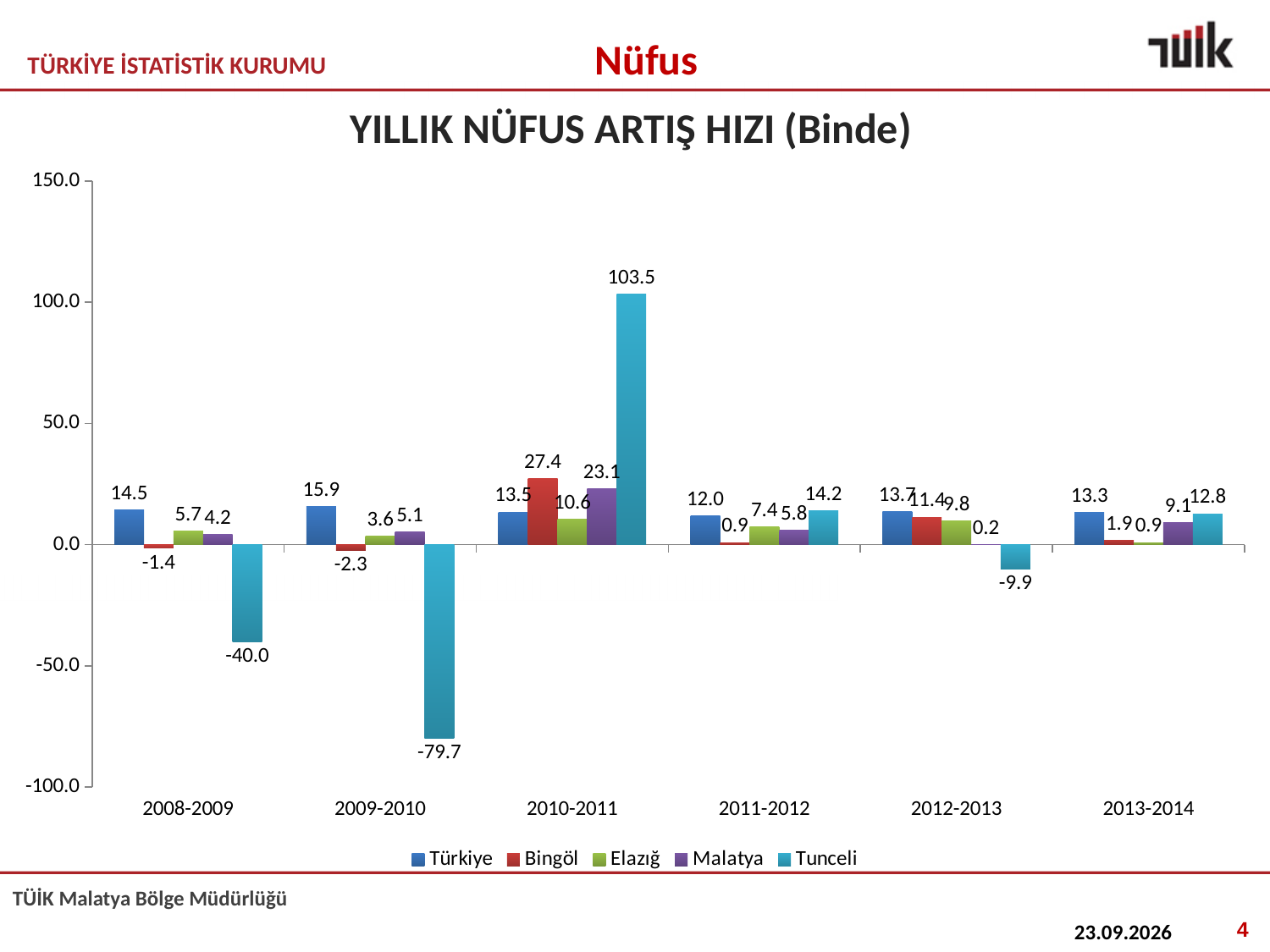
What is the value for Bingöl in 2009-2010? -2.3 What is the value for Malatya in 2012-2013? 0.2 What kind of chart is shown on the slide? Bar chart In which period does Tunceli have its lowest value? 2009-2010 What is the value for Tunceli in 2010-2011? 103.5 How many series does the legend list? 5 Which series has the highest value in 2010-2011? Tunceli What is the title of the chart? YILLIK NÜFUS ARTIŞ HIZI (Binde) Which is larger in 2012-2013, the value for Bingöl or the value for Elazığ? Bingöl How many periods are shown on the x axis? 6 What is the value for Türkiye in 2013-2014? 13.3 What is the difference between the Tunceli value and the Türkiye value in 2010-2011? 90.0